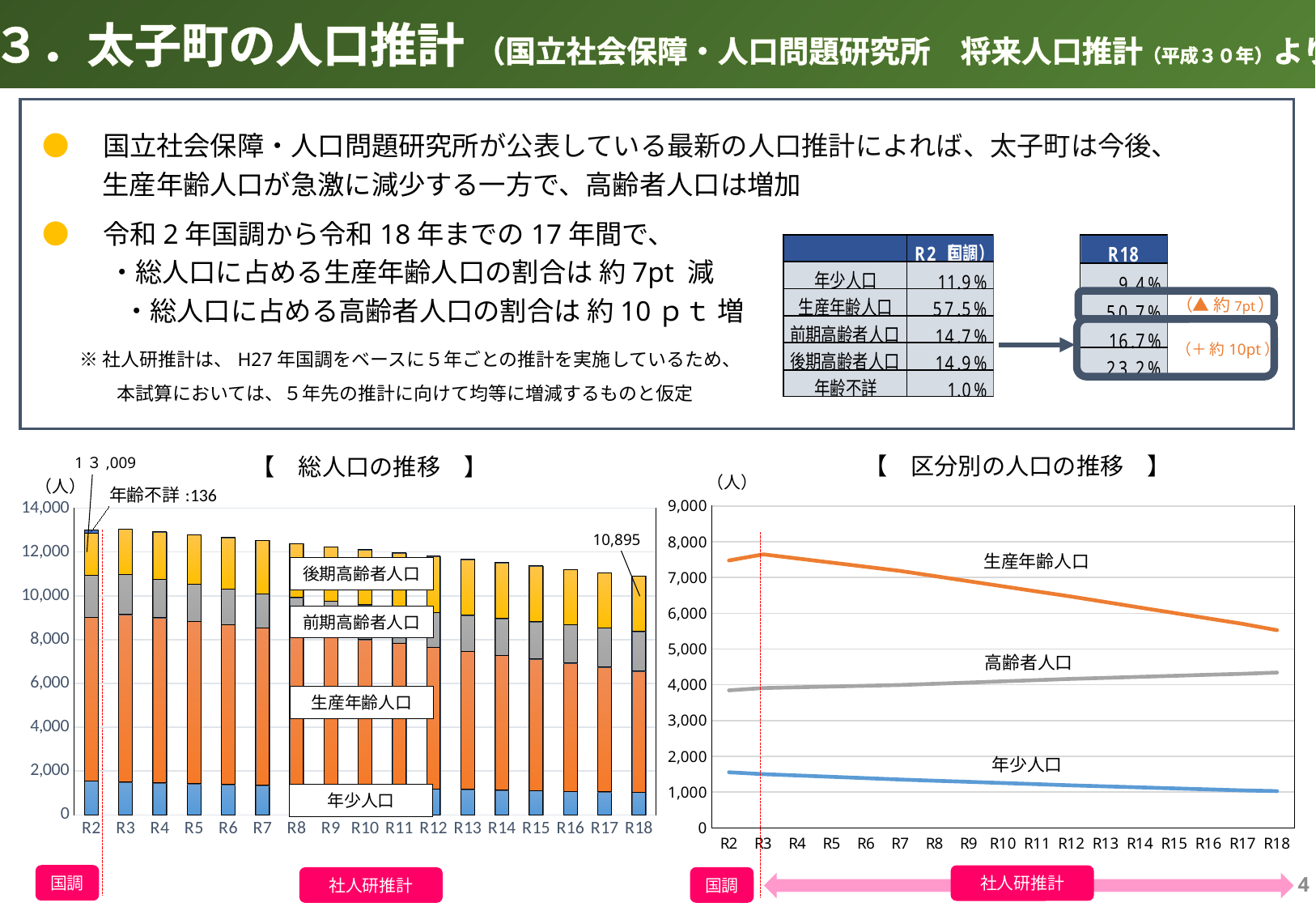
What type of chart is the left chart titled 総人口の推移? bar chart In the left chart 総人口の推移, what is the difference between the labeled totals for R2 and R18? 2,114 In the left chart 総人口の推移, what is the total population value labeled for R18? 10,895 In the right chart 区分別の人口の推移, is the value of 生産年齢人口 at R18 greater or less than 6,000? less In the left chart 総人口の推移, what is the total population value labeled for R2? 13,009 In the left chart 総人口の推移, which is larger, the total for R2 or the total for R18? R2 What type of chart is the right chart titled 区分別の人口の推移? line chart In the right chart 区分別の人口の推移, which series has the lowest values throughout? 年少人口 In the right chart 区分別の人口の推移, does the 生産年齢人口 line rise or fall from R3 to R18? fall In the left chart 総人口の推移, what is the value labeled for 年齢不詳 in R2? 136 In the left chart 総人口の推移, how many years (categories) are shown on the x axis? 17 In the right chart 区分別の人口の推移, which series has the highest values throughout? 生産年齢人口